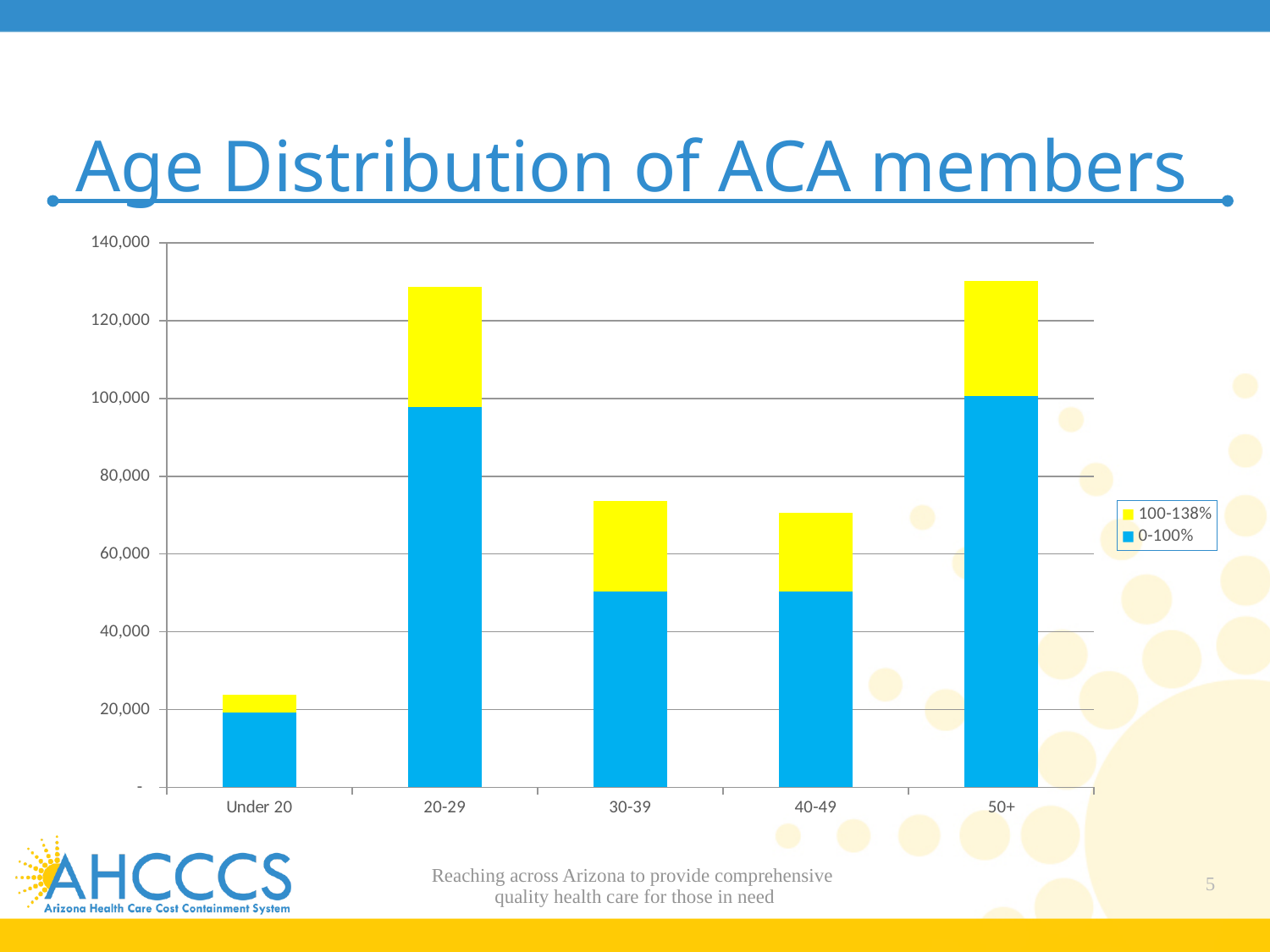
Which series is shown in yellow according to the legend? 100-138% Which age category has the lowest total bar? Under 20 What kind of chart is shown on the slide? Stacked bar chart Is the total value for Under 20 greater or less than 40,000? less How many series does the legend list? 2 How many age categories are shown on the x axis? 5 Is the total value for 40-49 greater or less than 80,000? less What is the title of the chart? Age Distribution of ACA members Which has the larger total bar, 20-29 or 40-49? 20-29 Is the 0-100% value for 50+ greater or less than 80,000? greater Which has the larger total bar, Under 20 or 30-39? 30-39